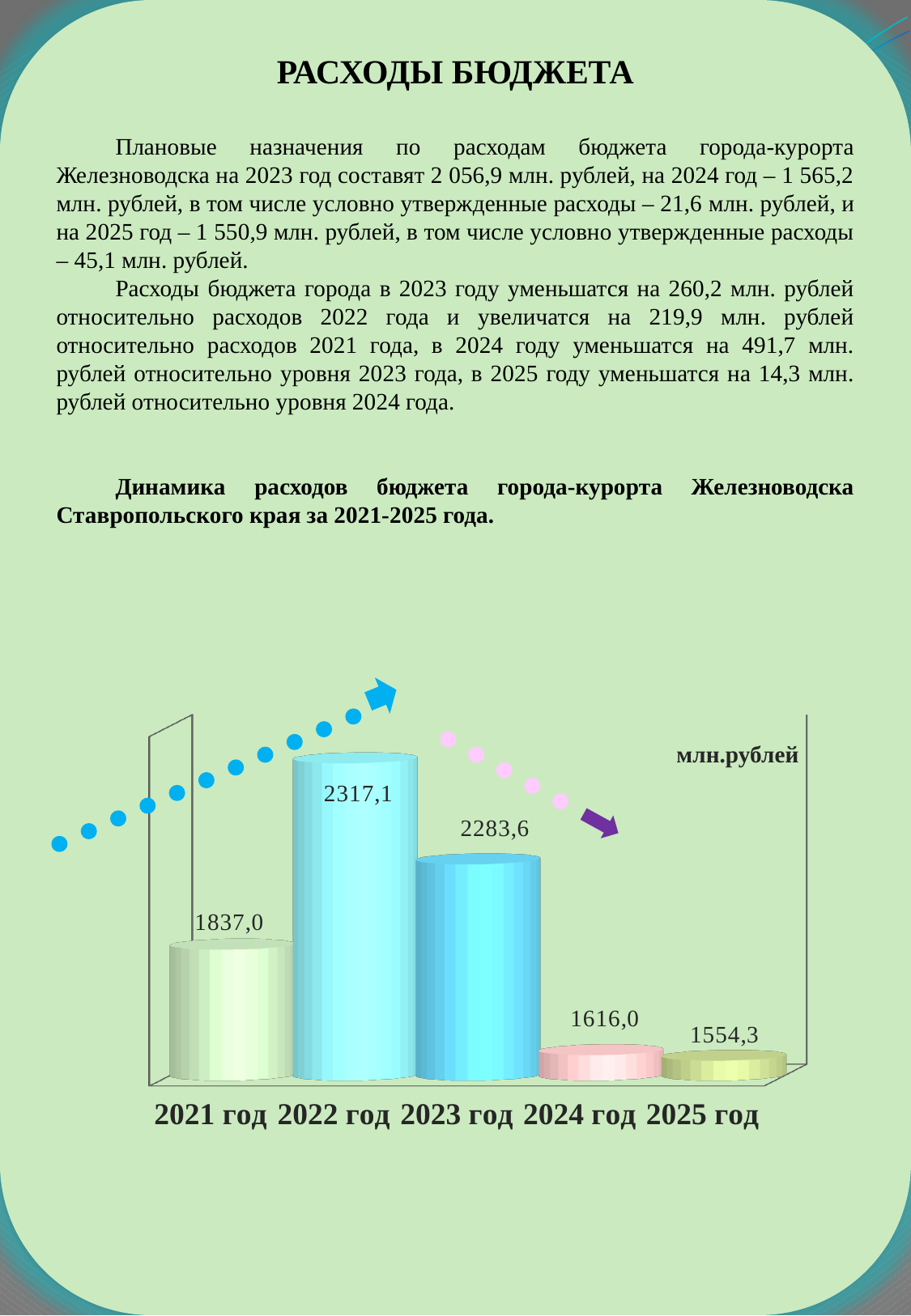
What is the value for 2023 год? 2283,6 Which year has the lowest value? 2025 год What is the difference between the values for 2022 год and 2023 год? 33,5 What is the value for 2025 год? 1554,3 Which year has the highest value? 2022 год Do the values rise or fall from 2022 год to 2025 год? fall Which is larger, the value for 2021 год or the value for 2025 год? 2021 год What is the value for 2022 год? 2317,1 What is the difference between the values for 2021 год and 2024 год? 221,0 What is the value for 2024 год? 1616,0 What is the value for 2021 год? 1837,0 How many years are shown on the chart? 5